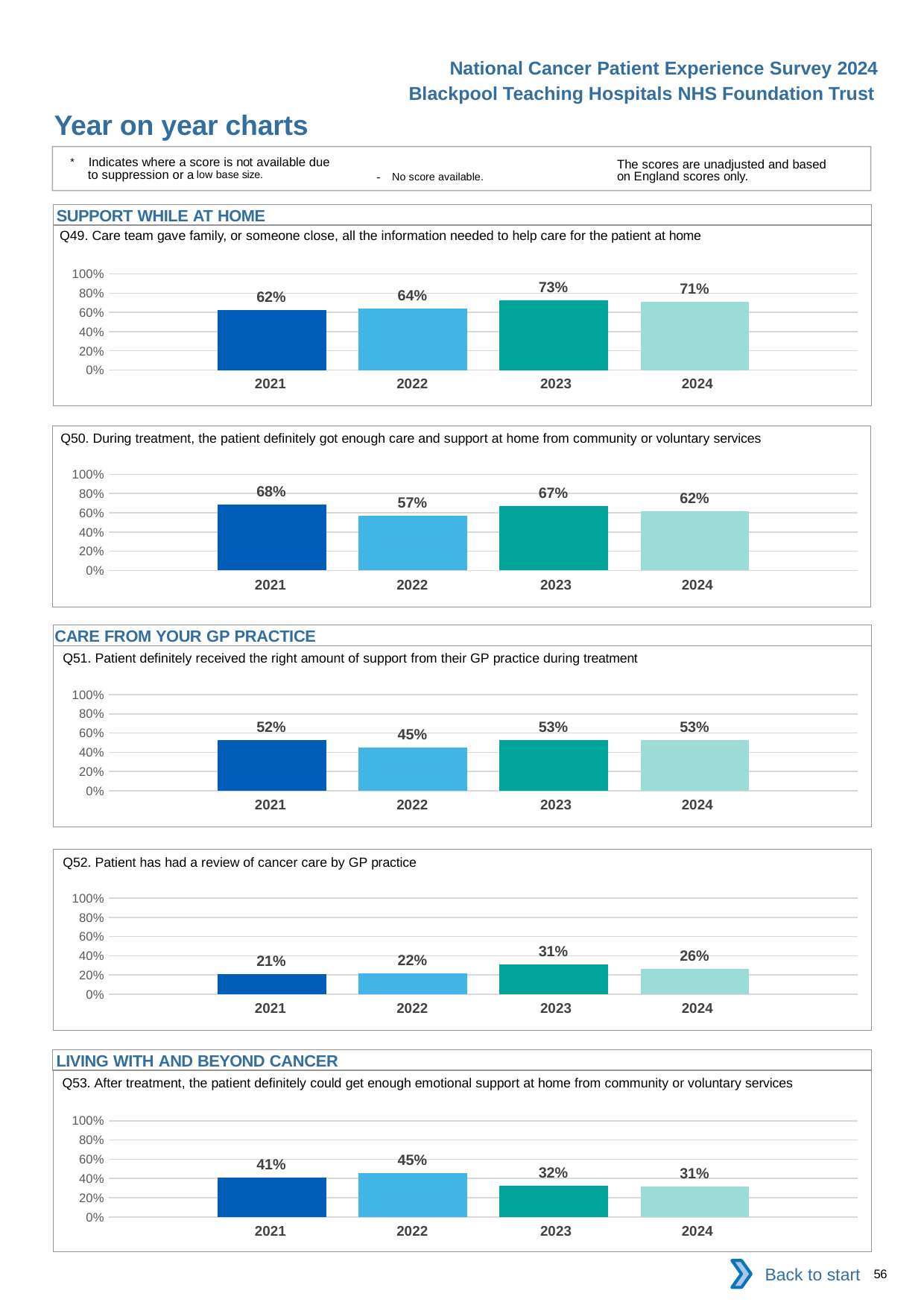
What type of chart is used for Q52? Bar chart In the Q51 chart, what is the value for 2024? 53% In the Q52 chart (patient has had a review of cancer care by GP practice), which year has the highest value? 2023 In the Q49 chart (care team gave family all the information needed to help care for the patient at home), what is the value for 2023? 73% In the Q53 chart, what is the difference between the 2022 and 2024 values? 14 percentage points How many years are plotted in the Q49 chart? 4 In the Q50 chart (patient definitely got enough care and support at home from community or voluntary services), what is the value for 2022? 57% In the Q50 chart, what is the difference between the 2021 and 2024 values? 6 percentage points In the Q52 chart, is the value for 2021 greater or less than 40%? less In the Q51 chart (patient definitely received the right amount of support from their GP practice), which year has the lowest value? 2022 In the Q49 chart, which year has the lowest value? 2021 In the Q53 chart (patient could get enough emotional support at home after treatment), which is larger, the value for 2022 or the value for 2023? 2022